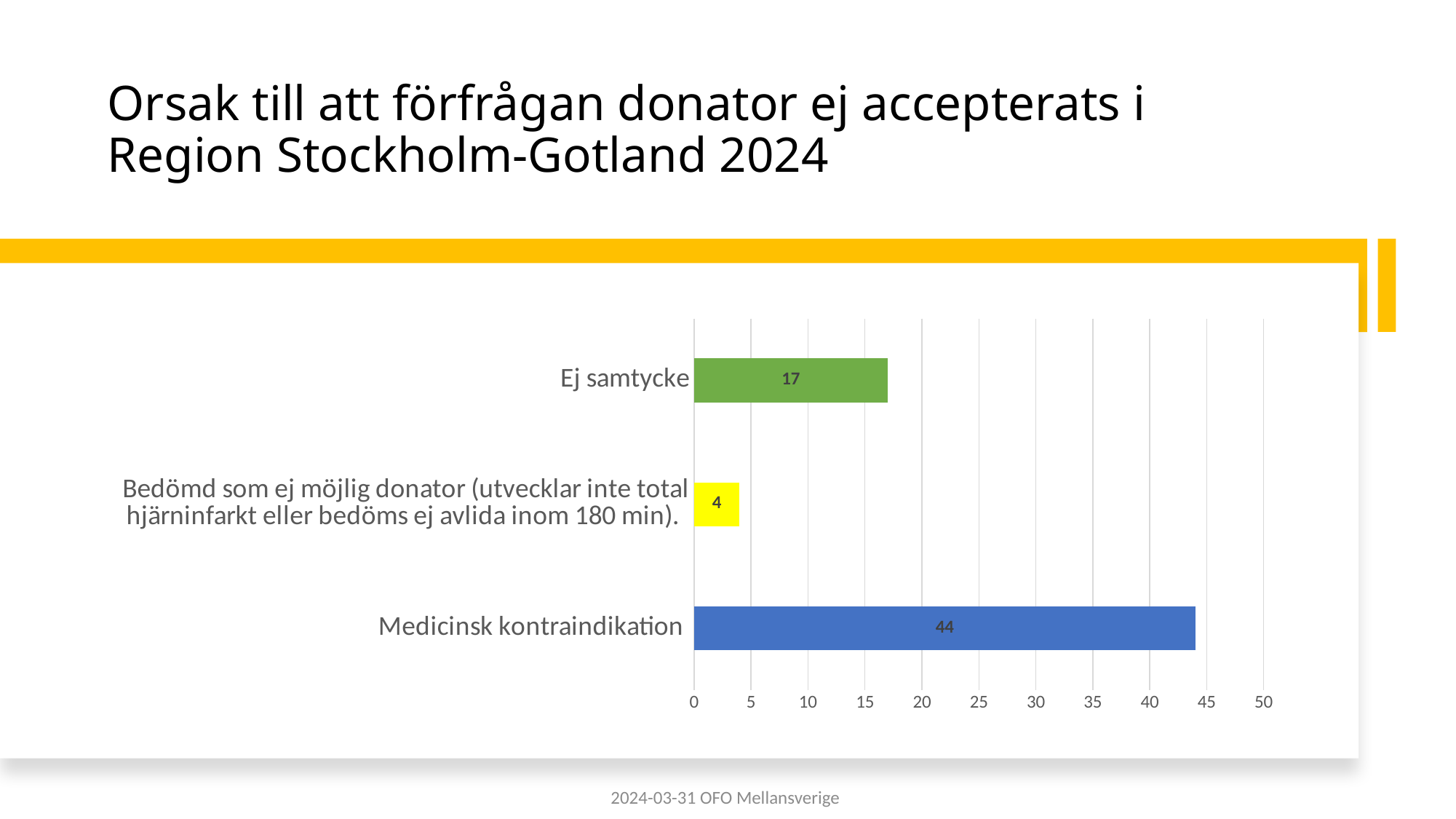
Which category has the lowest value? Bedömd som ej möjlig donator (utvecklar inte total hjärninfarkt eller bedöms ej avlida inom 180 min). What is the difference between the values for Medicinsk kontraindikation and Ej samtycke? 27 What colour is the bar for Ej samtycke? Green Which category has the highest value? Medicinsk kontraindikation What is the value for Medicinsk kontraindikation? 44 What is the total of the three values shown in the chart? 65 Is the value for Medicinsk kontraindikation greater or less than 40? greater How many categories are shown in the chart? 3 Which is larger, the value for Ej samtycke or the value for Bedömd som ej möjlig donator? Ej samtycke What is the value for Bedömd som ej möjlig donator (utvecklar inte total hjärninfarkt eller bedöms ej avlida inom 180 min)? 4 What kind of chart is shown on the slide? Bar chart What is the value for Ej samtycke? 17